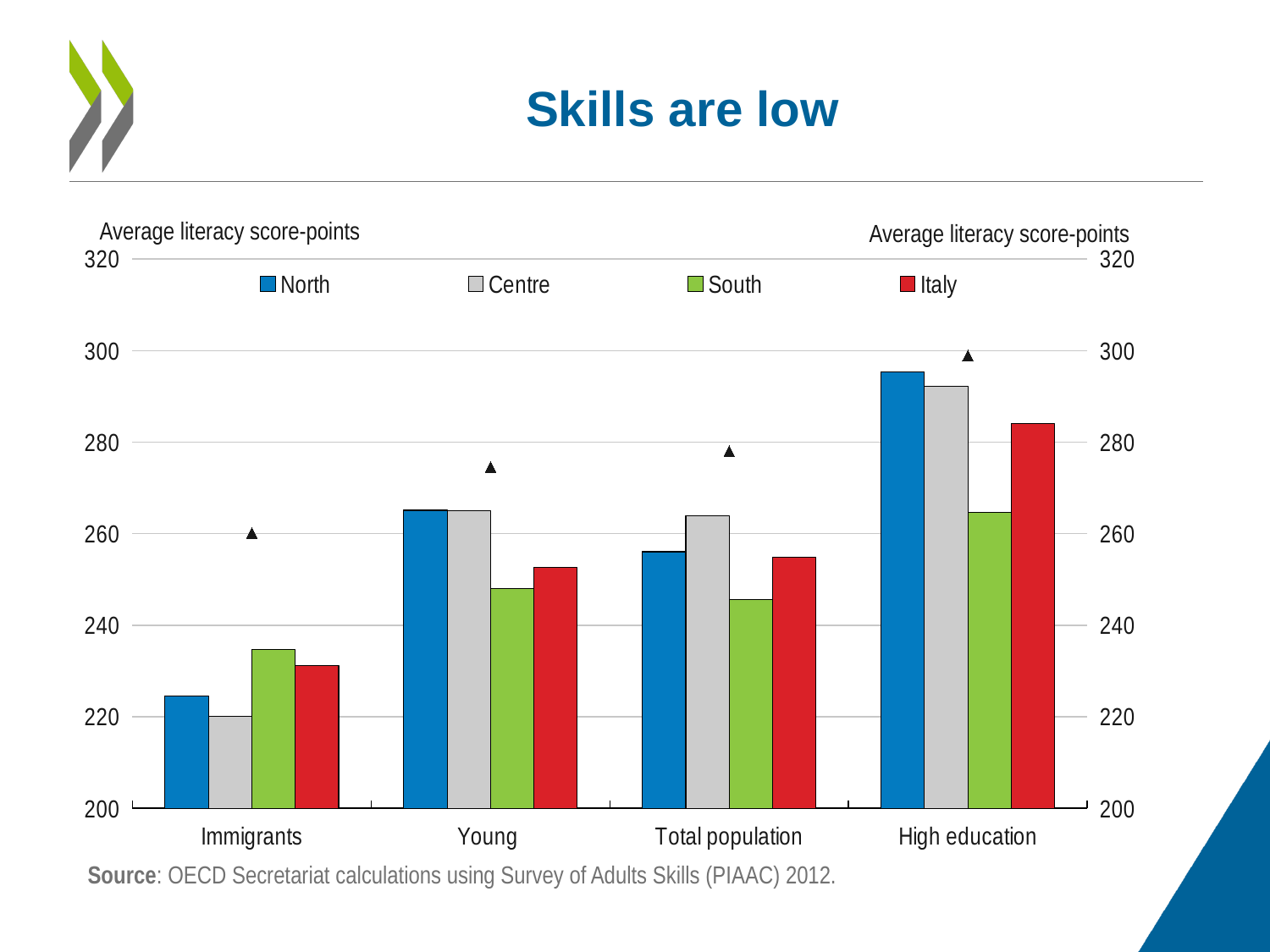
Is the value for Centre in the Total population category greater or less than 260? greater How many categories are shown on the x axis? 4 How many series does the legend list? 4 In the High education category, which is larger: North or South? North Is the value for South in the Young category greater or less than 260? less What kind of chart is shown on the slide? Bar chart In which category is the North bar highest? High education In the Immigrants category, which is larger: South or Centre? South In which category is the South bar lowest? Immigrants What is the label on the vertical axis of the chart? Average literacy score-points Is the value for South in the High education category greater or less than 260? greater